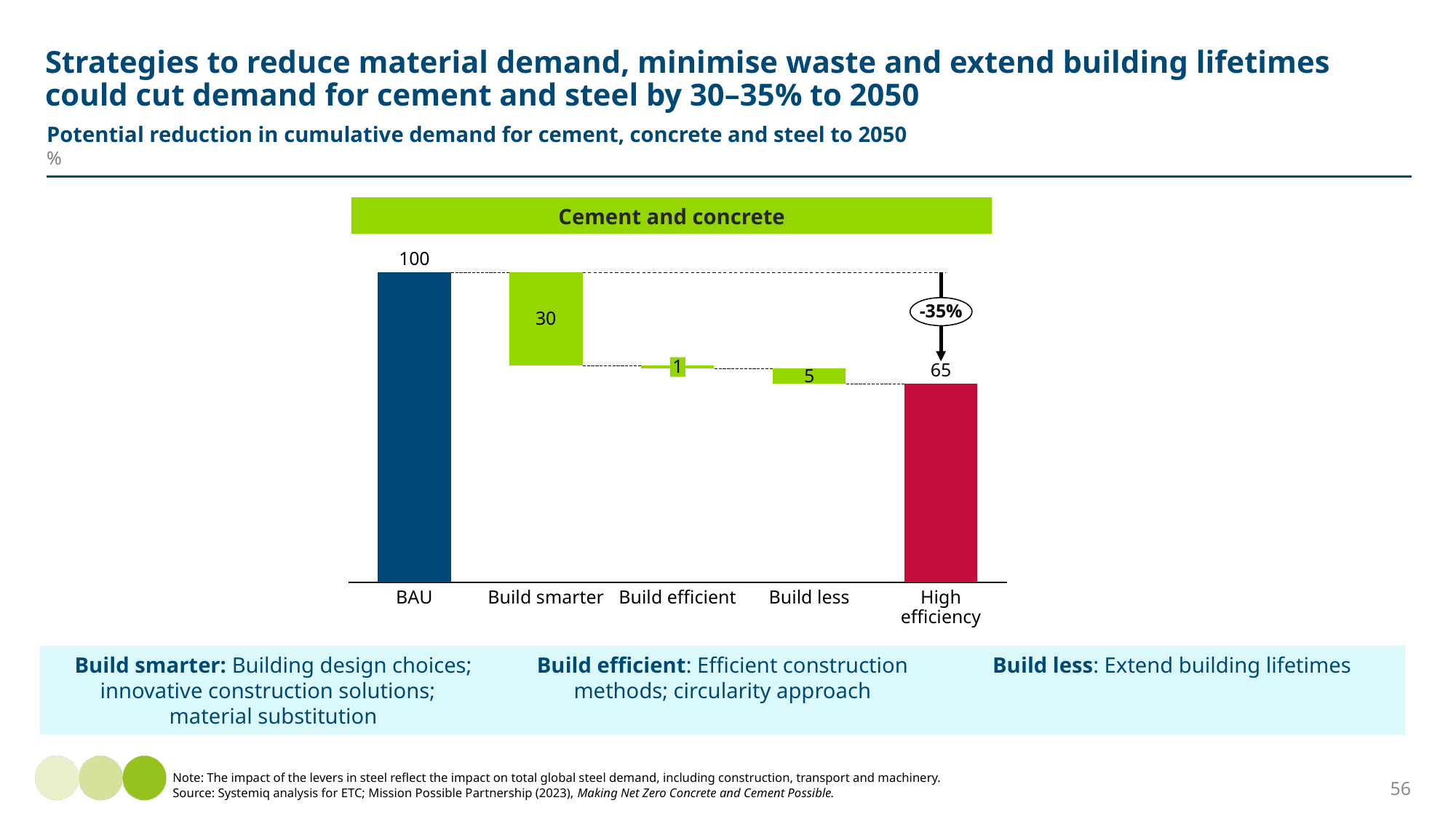
Which of the three reduction levers (Build smarter, Build efficient, Build less) has the smallest value? Build efficient How many categories are shown on the x axis of the chart? 5 What is the value shown for Build less? 5 What is the value of the BAU bar? 100 What is the label in the green header box above the chart? Cement and concrete Which of the three reduction levers (Build smarter, Build efficient, Build less) has the largest value? Build smarter Which is larger, the value for Build less or the value for Build efficient? Build less What is the value shown for Build smarter? 30 What is the value shown for Build efficient? 1 What is the difference between the BAU value and the High efficiency value? 35 What percentage change is shown in the oval between BAU and High efficiency? -35% What is the value of the High efficiency bar? 65